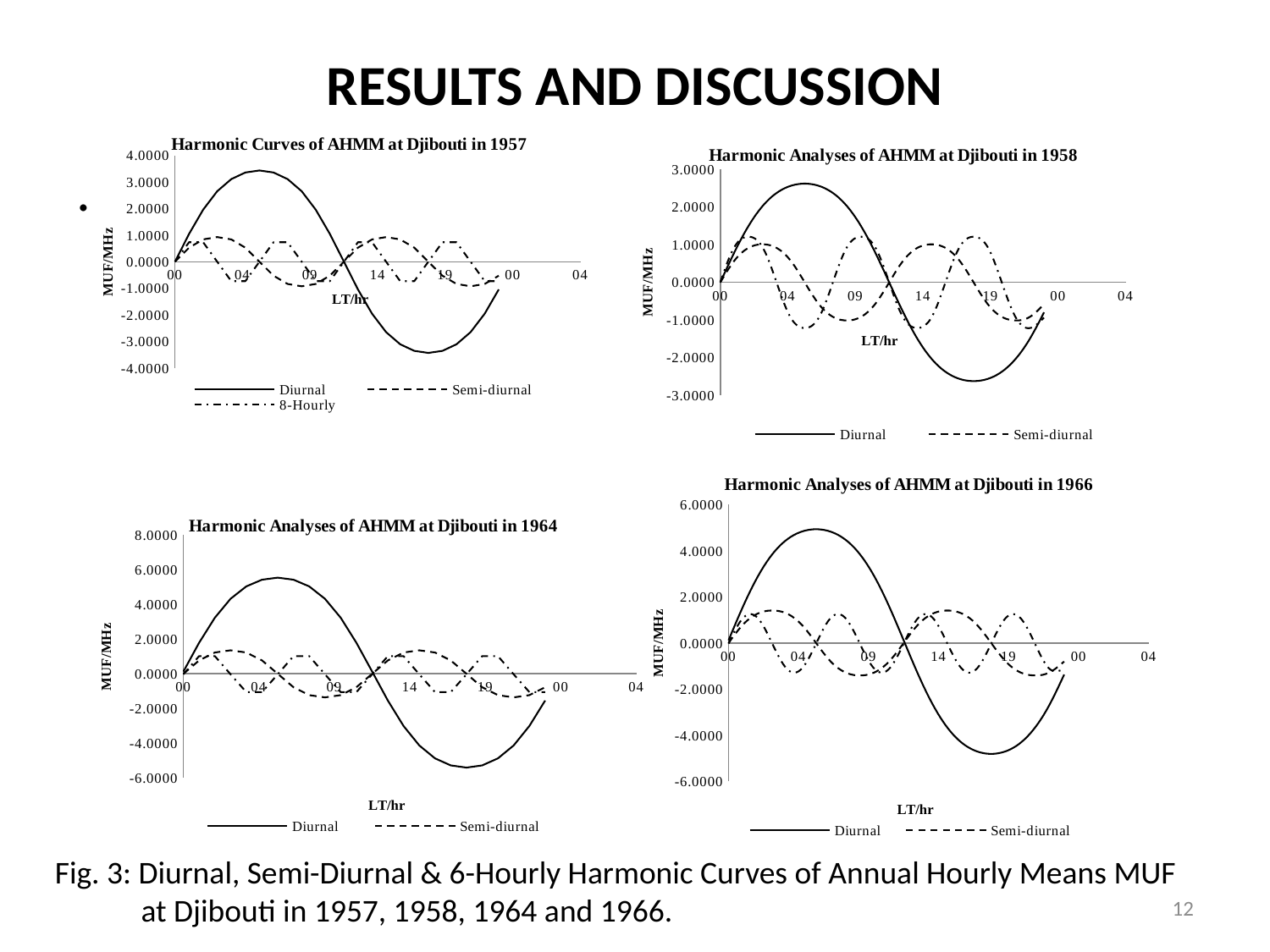
In the chart "Harmonic Curves of AHMM at Djibouti in 1957", is the peak value of the Diurnal curve greater or less than 3.0000? greater In the chart "Harmonic Analyses of AHMM at Djibouti in 1958", is the peak value of the Diurnal curve greater or less than 2.0000? greater How many series does the legend list in the chart "Harmonic Analyses of AHMM at Djibouti in 1964"? 2 What kind of chart is "Harmonic Curves of AHMM at Djibouti in 1957"? Line chart How many series does the legend list in the chart "Harmonic Curves of AHMM at Djibouti in 1957"? 3 In the chart "Harmonic Curves of AHMM at Djibouti in 1957", does the Diurnal curve rise or fall between 00 and 04 LT/hr? rise What is the y-axis title of the chart "Harmonic Analyses of AHMM at Djibouti in 1958"? MUF/MHz In the chart "Harmonic Analyses of AHMM at Djibouti in 1964", which series has the larger peak value, Diurnal or Semi-diurnal? Diurnal In the chart "Harmonic Analyses of AHMM at Djibouti in 1966", does the Diurnal curve rise or fall between 09 and 19 LT/hr? fall In the chart "Harmonic Analyses of AHMM at Djibouti in 1966", is the lowest value of the Diurnal curve greater or less than -4.0000? less Which series is listed third in the legend of the chart "Harmonic Curves of AHMM at Djibouti in 1957"? 8-Hourly